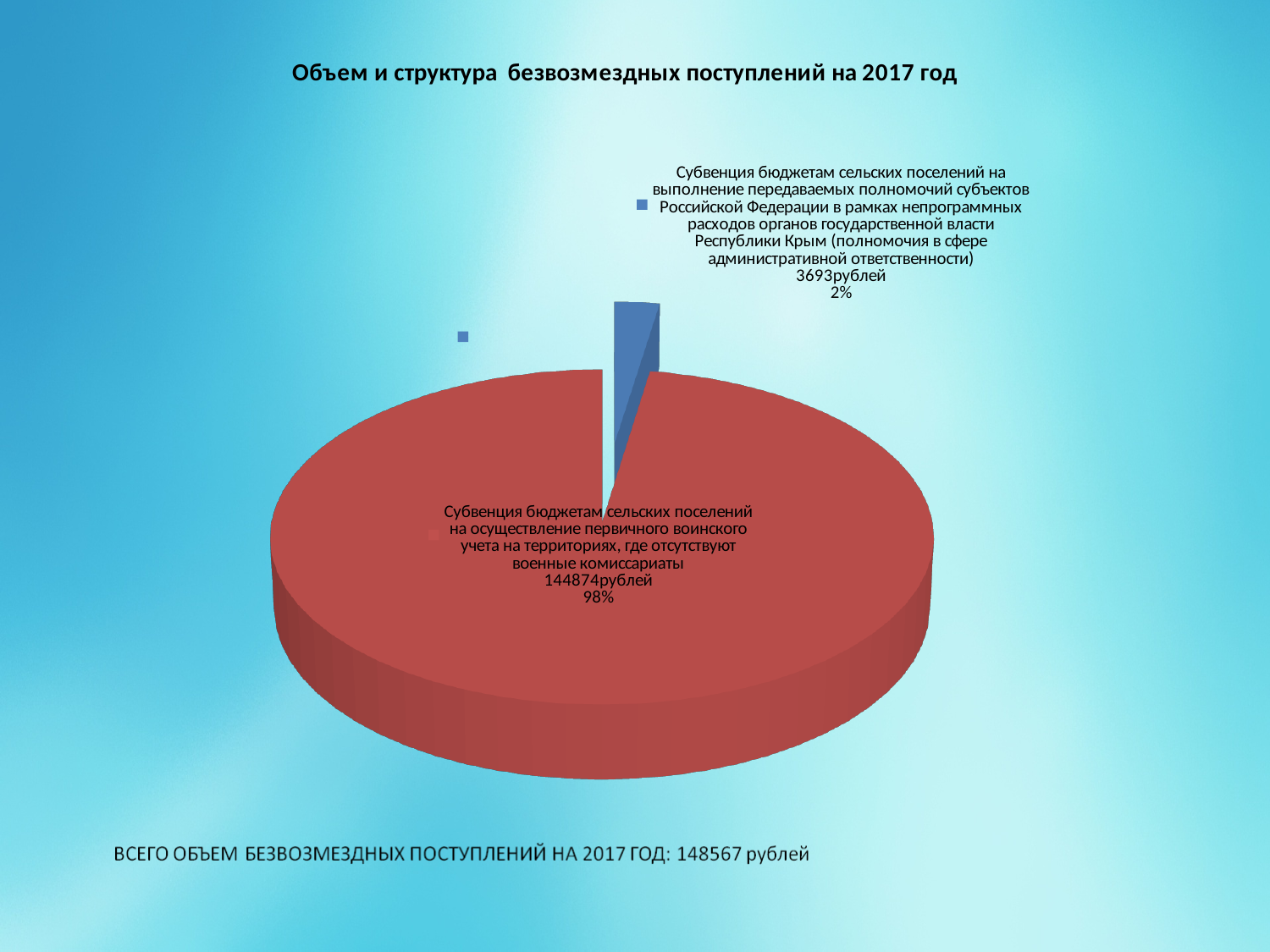
What is the value for the subvention for administrative responsibility powers (полномочия в сфере административной ответственности)? 3693рублей What is the title of the chart? Объем и структура безвозмездных поступлений на 2017 год What is the difference in rubles between the subvention for primary military registration and the subvention for administrative responsibility powers? 141181 рублей What share of the pie does the subvention for primary military registration take? 98% What is the value for the subvention for primary military registration (Субвенция бюджетам сельских поселений на осуществление первичного воинского учета)? 144874рублей Which is larger: the subvention for primary military registration or the subvention for administrative responsibility powers? the subvention for primary military registration What kind of chart is shown on the slide? pie chart What is the total volume of gratuitous receipts for 2017 stated on the slide? 148567 рублей What share of the pie does the subvention for administrative responsibility powers take? 2% How many slices does the pie chart have? 2 Which category is the largest in the pie chart? Субвенция бюджетам сельских поселений на осуществление первичного воинского учета на территориях, где отсутствуют военные комиссариаты